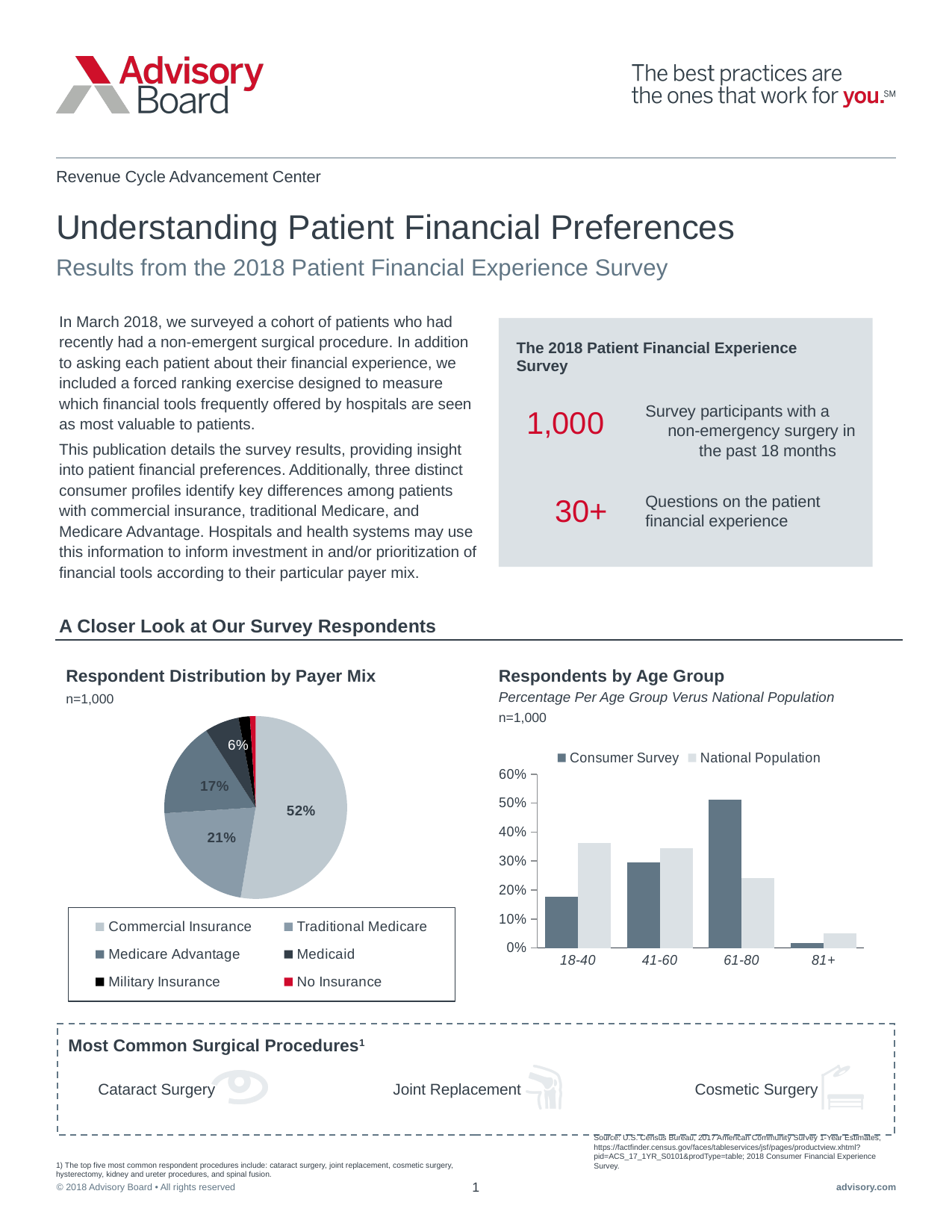
In the Respondents by Age Group chart, is the Consumer Survey value for 61-80 greater or less than 40%? greater What type of chart is the Respondent Distribution by Payer Mix chart? Pie chart In the Respondent Distribution by Payer Mix chart, how many payer categories does the legend list? 6 In the Respondent Distribution by Payer Mix chart, what percentage of respondents have Traditional Medicare? 21% In the Respondent Distribution by Payer Mix chart, what percentage of respondents have Commercial Insurance? 52% In the Respondent Distribution by Payer Mix chart, what percentage of respondents have Medicare Advantage? 17% In the Respondents by Age Group chart, for the 18-40 age group, which is larger: Consumer Survey or National Population? National Population In the Respondents by Age Group chart, how many series does the legend list? 2 In the Respondents by Age Group chart, which age group has the highest Consumer Survey value? 61-80 In the Respondent Distribution by Payer Mix chart, what is the difference in percentage points between Commercial Insurance and Traditional Medicare? 31 In the Respondents by Age Group chart, which age group has the lowest Consumer Survey value? 81+ In the Respondent Distribution by Payer Mix chart, which payer category has the largest share? Commercial Insurance